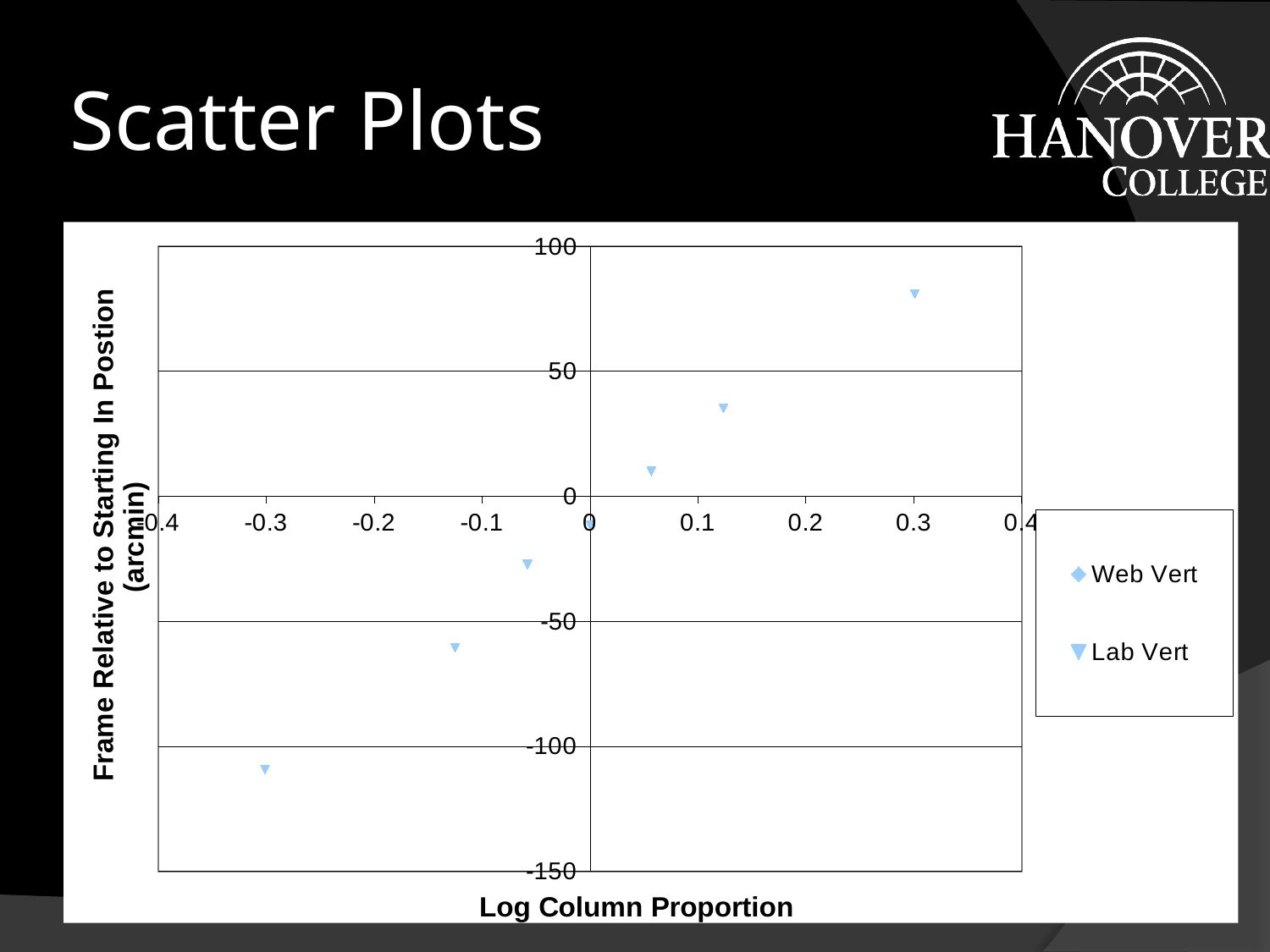
Is the value of the Lab Vert point near x = 0.3 greater or less than 50? greater Which is larger: the value of the point near x = 0.3 or the value of the point near x = 0.125? the point near x = 0.3 Is the value of the Lab Vert point near x = -0.3 greater or less than -100? less What is the title of the x axis? Log Column Proportion Is the value of the Lab Vert point near x = 0.125 greater or less than 50? less How many data points are plotted on the chart? 6 What kind of chart is shown on the slide? scatter plot Do the plotted values rise or fall as Log Column Proportion increases along the x axis? rise How many series does the legend list? 2 What are the two series names listed in the legend? Web Vert and Lab Vert